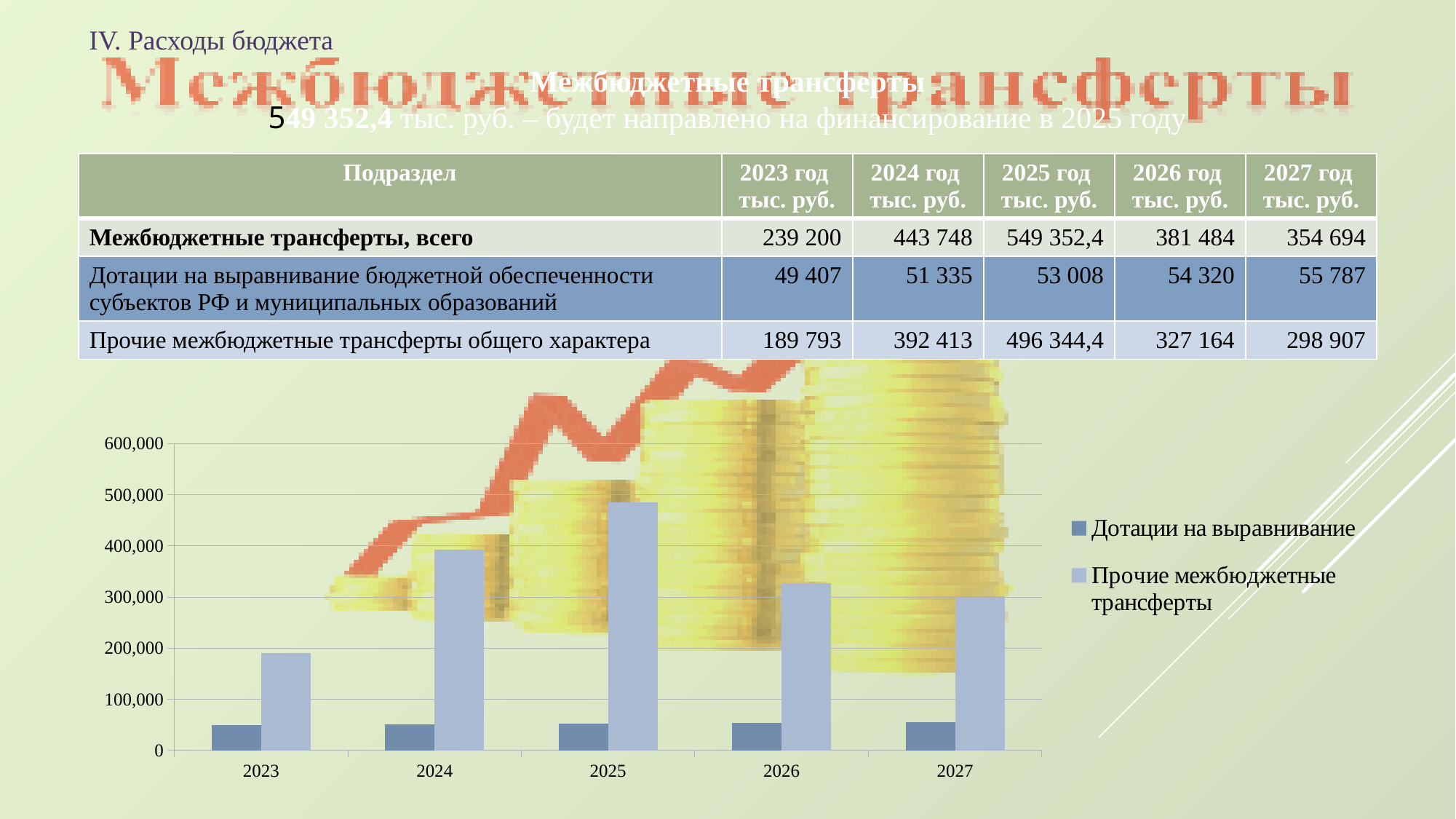
Is the value for Дотации на выравнивание in 2027 greater or less than 100,000? less How many series does the chart legend list? 2 Does the value for Прочие межбюджетные трансферты rise or fall from 2025 to 2027? fall What kind of chart is shown on the slide? bar chart In which year is the bar for Прочие межбюджетные трансферты the lowest? 2023 Is the value for Прочие межбюджетные трансферты in 2025 greater or less than 400,000? greater How many years are shown on the x axis of the chart? 5 Does the value for Дотации на выравнивание rise or fall from 2023 to 2027? rise Is the value for Прочие межбюджетные трансферты in 2023 greater or less than 200,000? less Which is larger in 2026: Дотации на выравнивание or Прочие межбюджетные трансферты? Прочие межбюджетные трансферты In which year is the bar for Прочие межбюджетные трансферты the highest? 2025 Which series is shown in the darker blue bars in the chart? Дотации на выравнивание